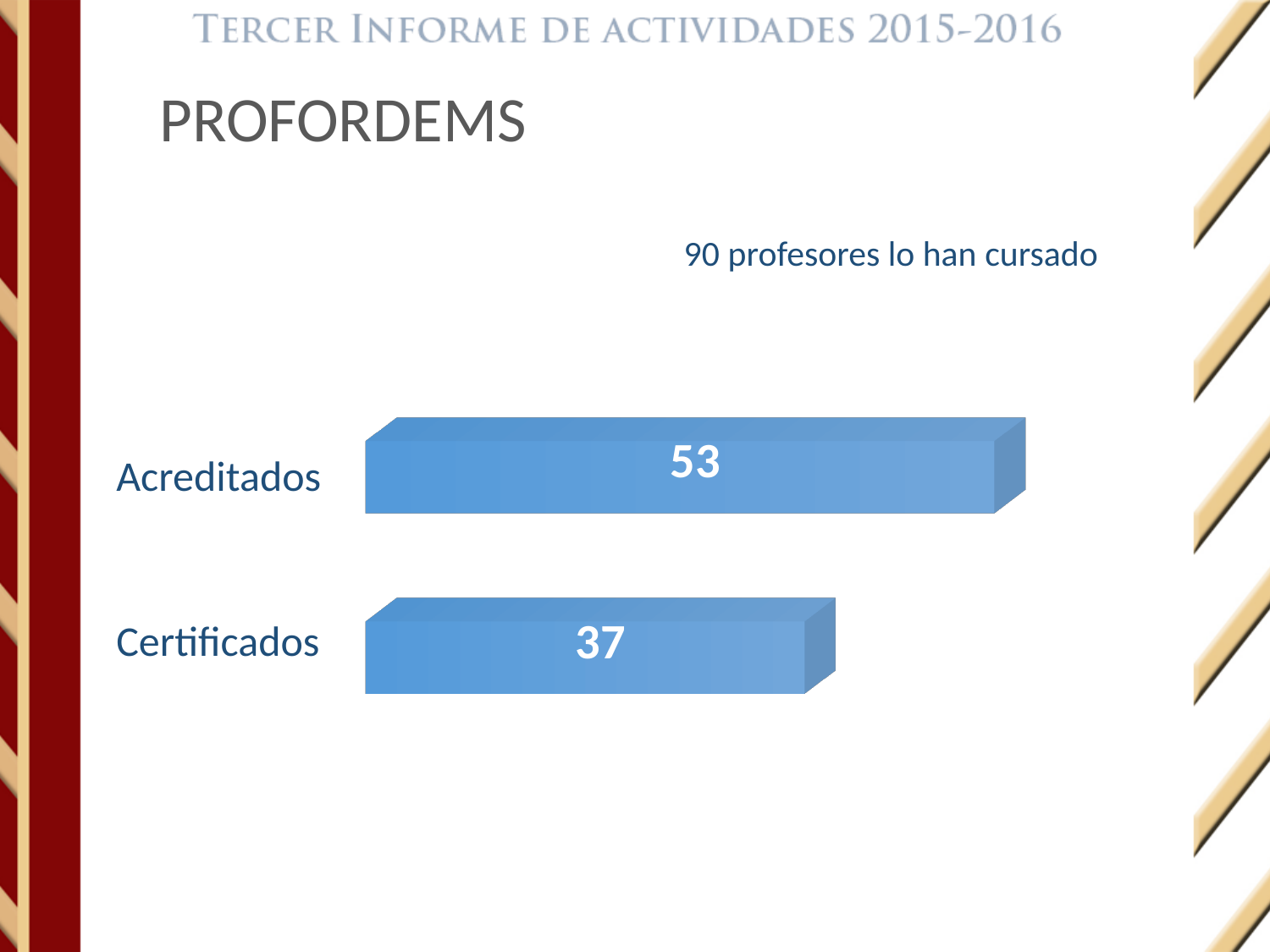
Which category has the highest value? Acreditados How many categories are shown in the chart? 2 According to the text above the chart, how many professors have taken the course? 90 What is the difference between the values for Acreditados and Certificados? 16 What kind of chart is shown on the slide? Bar chart What is the value for Certificados? 37 What colour are the bars in the chart? Blue Which category has the lowest value? Certificados Which is larger, the value for Acreditados or the value for Certificados? Acreditados What is the value for Acreditados? 53 What is the total of the values for Acreditados and Certificados? 90